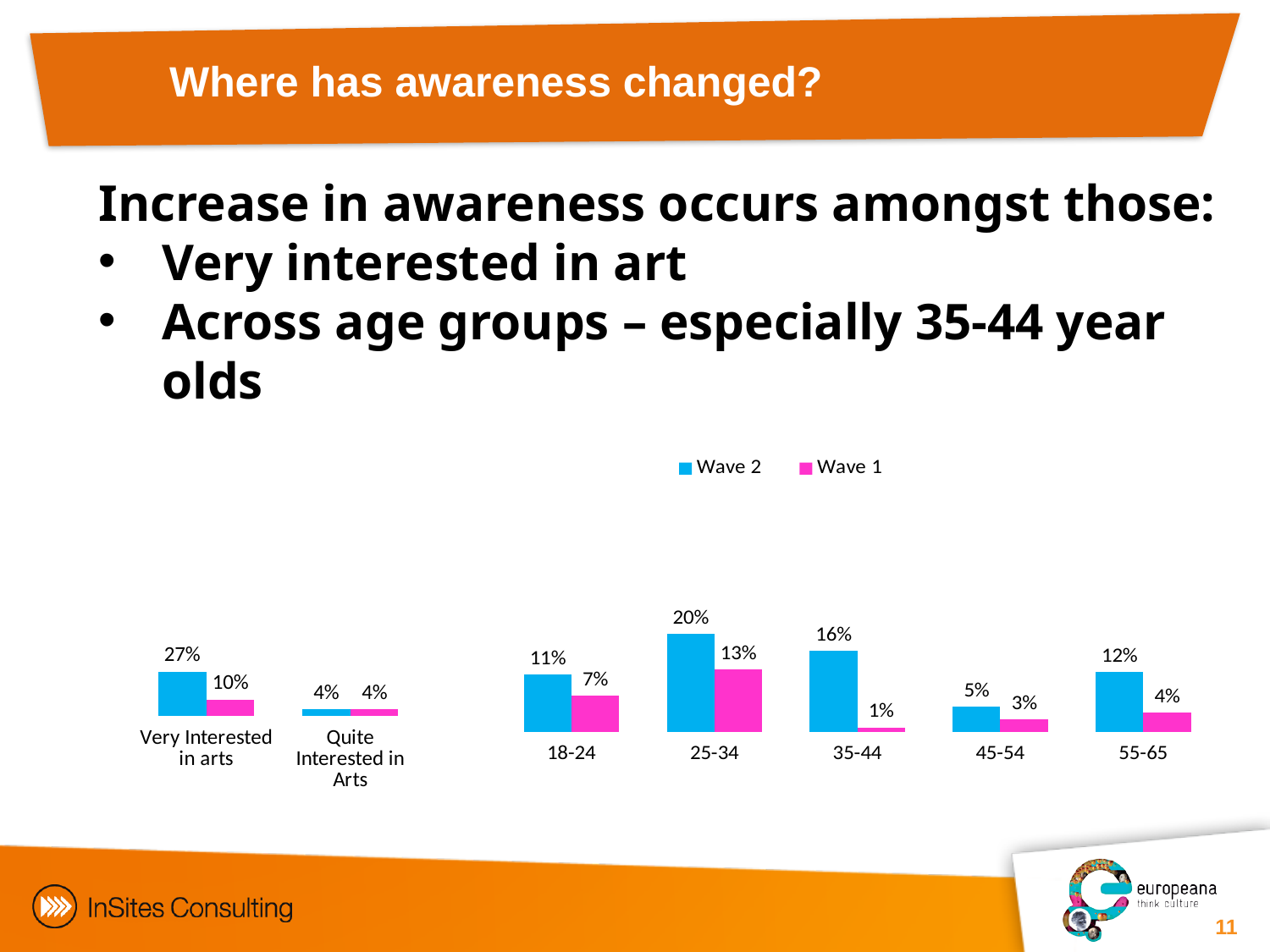
In the right chart, what is the Wave 1 value for the 35-44 age group? 1% How many age groups are shown in the right chart? 5 In the right chart, what is the difference between the Wave 2 and Wave 1 values for the 25-34 age group? 7% In the right chart, which is larger: the Wave 2 value for 18-24 or the Wave 2 value for 55-65? 55-65 In the right chart, which age group has the lowest Wave 1 value? 35-44 In the left chart, what is the difference between the Wave 2 and Wave 1 values for Very Interested in arts? 17% In the left chart, what is the Wave 2 value for Very Interested in arts? 27% In the right chart, what is the Wave 2 value for the 35-44 age group? 16% In the right chart, which age group has the highest Wave 2 value? 25-34 How many series does the legend list? 2 In the left chart, what is the Wave 1 value for Very Interested in arts? 10% What type of chart is the right chart? Bar chart